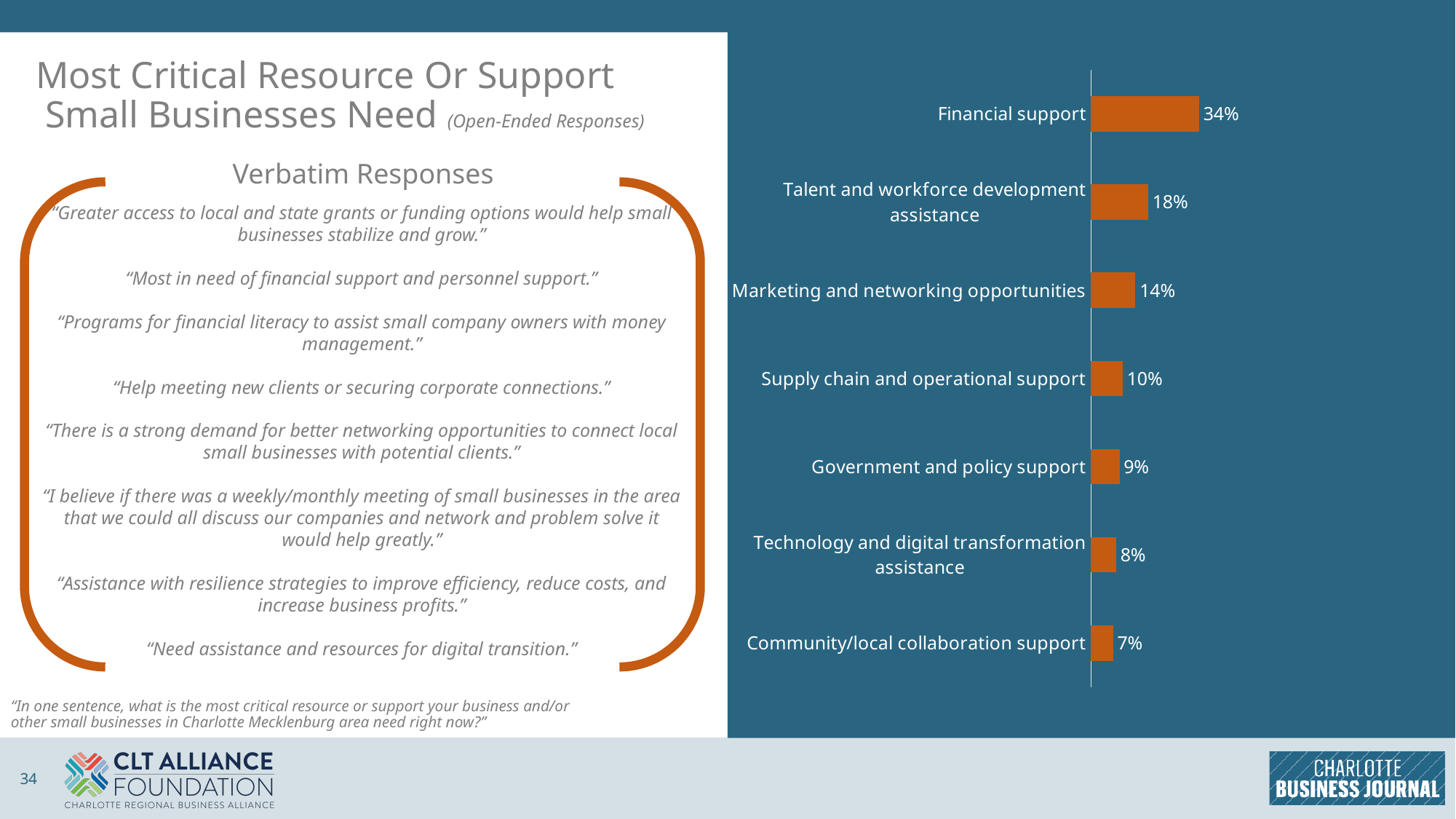
What colour are the bars in the chart? Orange What is the difference between Supply chain and operational support and Government and policy support? 1% Which category has the highest value in the chart? Financial support Which is larger: Marketing and networking opportunities or Supply chain and operational support? Marketing and networking opportunities Which category has the lowest value in the chart? Community/local collaboration support What is the value for Talent and workforce development assistance? 18% What is the value for Marketing and networking opportunities? 14% What is the difference between the values for Financial support and Talent and workforce development assistance? 16% How many categories are shown in the bar chart? 7 What type of chart is shown on the slide? Bar chart What percentage of responses cited Financial support as the most critical resource? 34% What is the value for Technology and digital transformation assistance? 8%